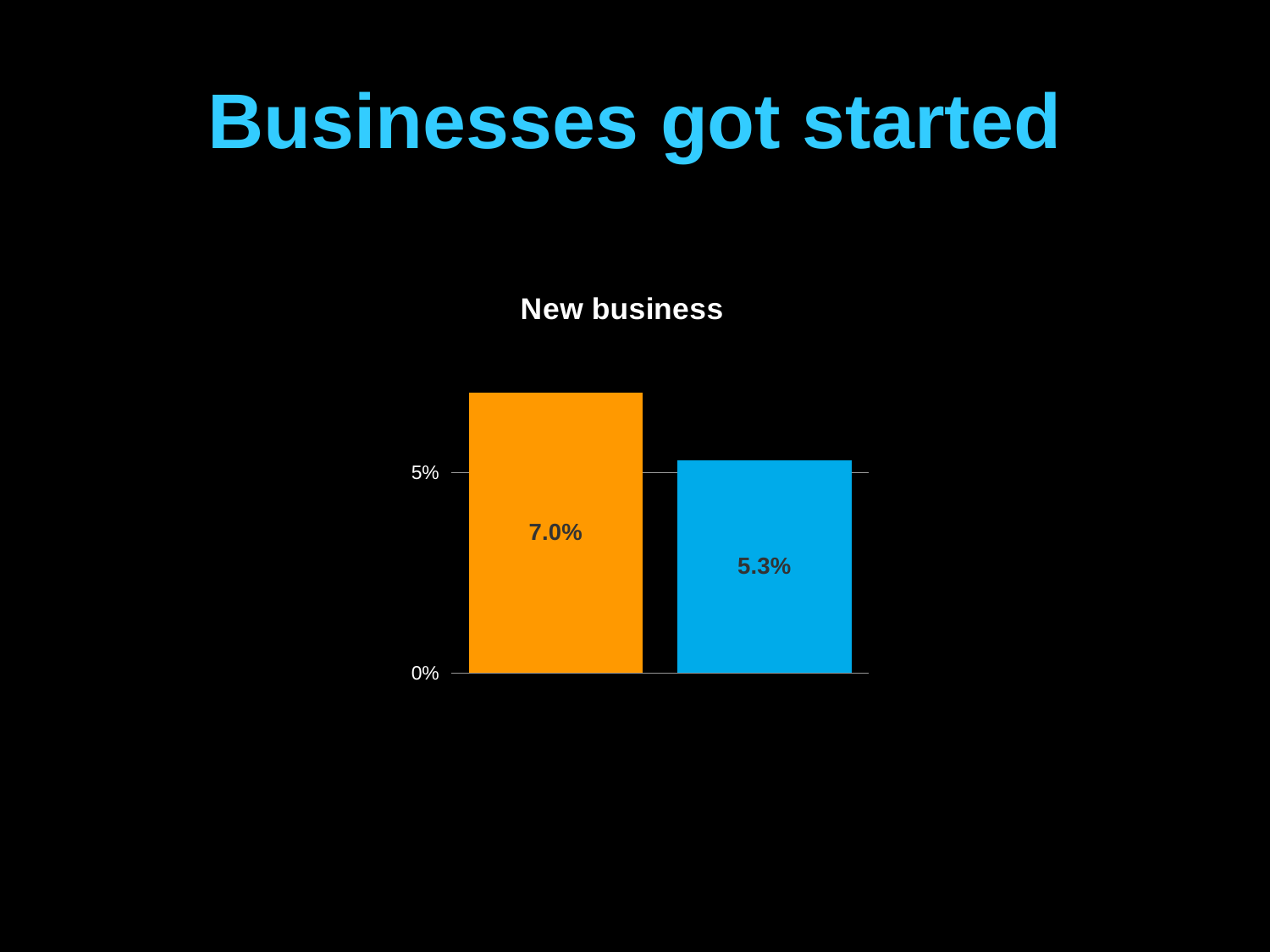
What is the difference between the orange bar and the blue bar in the New business chart? 1.7% Which bar is taller in the New business chart, the orange one or the blue one? the orange one What is the value of the blue bar in the New business chart? 5.3% What is the title of the chart on the slide? New business Is the value of the blue bar in the New business chart greater or less than 5%? greater What is the value of the orange bar in the New business chart? 7.0% What is the highest value shown in the New business chart? 7.0% Which bar has the lowest value in the New business chart? the blue bar What is the highest tick label shown on the vertical axis of the New business chart? 5% Is the value of the orange bar in the New business chart greater or less than 5%? greater What kind of chart is shown on the slide? bar chart How many bars are plotted in the New business chart? 2